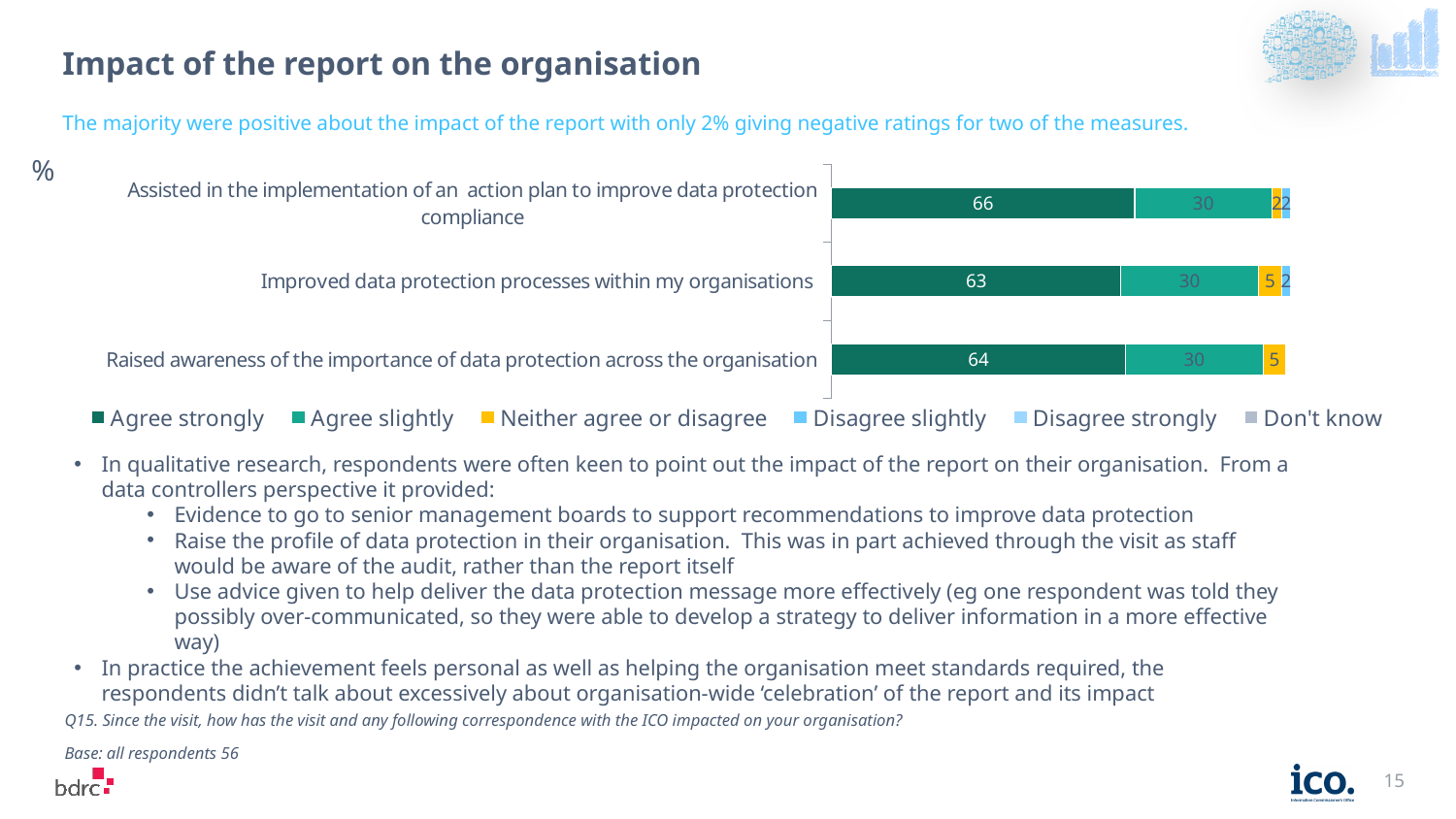
What percentage agreed strongly that the report assisted in the implementation of an action plan to improve data protection compliance? 66 What percentage agreed strongly that the report raised awareness of the importance of data protection across the organisation? 64 Which statement has the lowest 'Agree strongly' value? Improved data protection processes within my organisations What kind of chart is shown on the slide? Stacked bar chart What is the difference between the 'Agree strongly' values for 'Assisted in the implementation of an action plan' and 'Improved data protection processes'? 3 How many series does the legend list? 6 Which has a larger 'Agree strongly' value: 'Raised awareness of the importance of data protection' or 'Improved data protection processes'? Raised awareness of the importance of data protection across the organisation What is the 'Neither agree or disagree' value for 'Improved data protection processes within my organisations'? 5 Which statement has the highest 'Agree strongly' value? Assisted in the implementation of an action plan to improve data protection compliance What percentage agreed strongly that the report improved data protection processes within their organisation? 63 What is the 'Agree slightly' value for 'Raised awareness of the importance of data protection across the organisation'? 30 How many statements (categories) are shown in the chart? 3